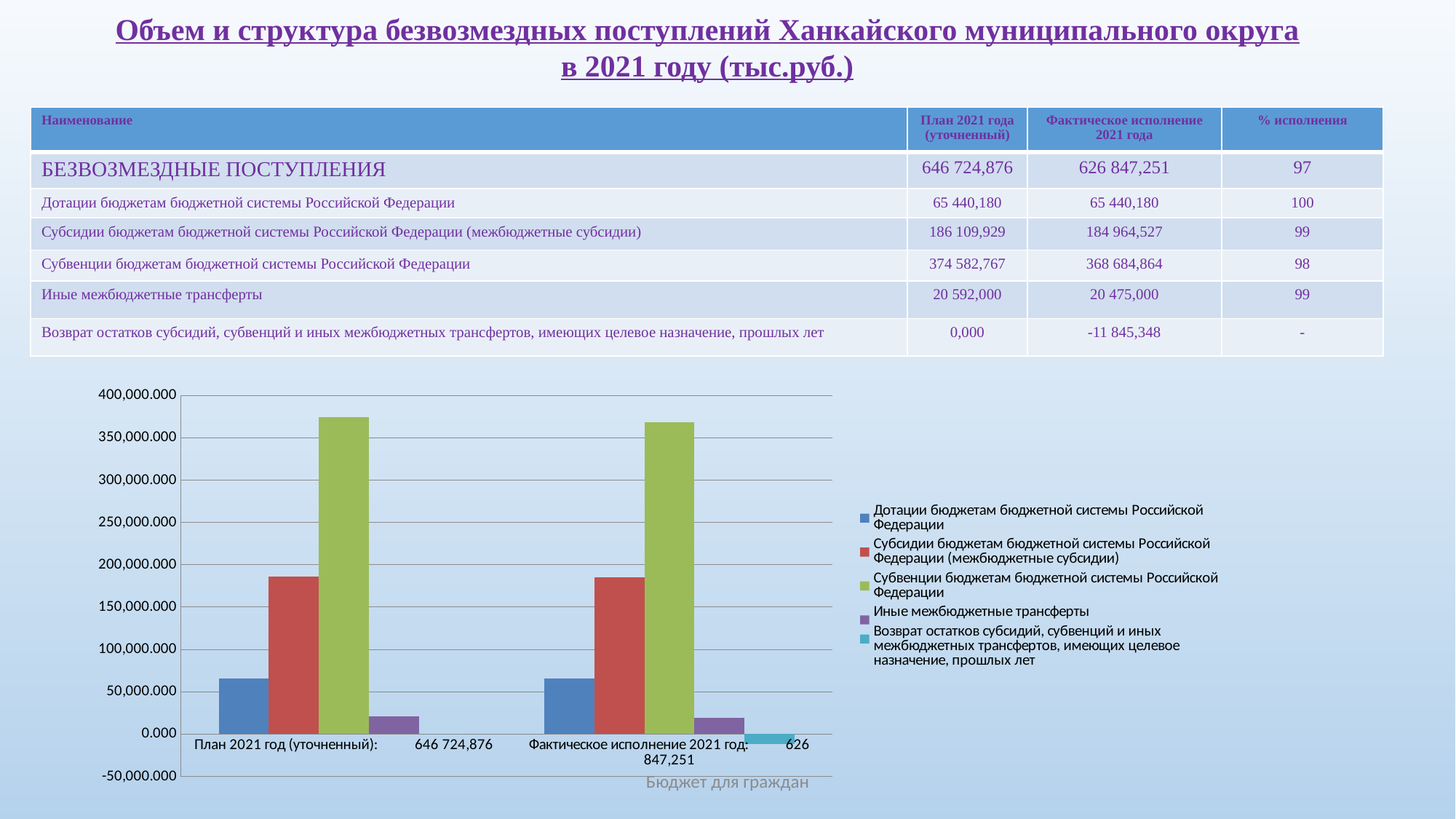
In the План 2021 год (уточненный) group, which series has the tallest bar? Субвенции бюджетам бюджетной системы Российской Федерации What total is printed in the x-axis label for the Фактическое исполнение 2021 год group? 626 847,251 Is the value for Дотации бюджетам бюджетной системы Российской Федерации in the План 2021 год (уточненный) group greater or less than 50,000.000? greater How many category groups are shown along the x axis of the chart? 2 What colour are the bars for Субвенции бюджетам бюджетной системы Российской Федерации in the chart? green In the Фактическое исполнение 2021 год group, which series has the lowest bar? Возврат остатков субсидий, субвенций и иных межбюджетных трансфертов, имеющих целевое назначение, прошлых лет What kind of chart is shown on the slide? bar chart In the План 2021 год (уточненный) group, which is larger: the bar for Субсидии бюджетам бюджетной системы Российской Федерации (межбюджетные субсидии) or the bar for Дотации бюджетам бюджетной системы Российской Федерации? Субсидии бюджетам бюджетной системы Российской Федерации (межбюджетные субсидии) Is the value for Возврат остатков субсидий, субвенций и иных межбюджетных трансфертов in the Фактическое исполнение 2021 год group greater or less than 0.000? less Is the value for Субвенции бюджетам бюджетной системы Российской Федерации in the План 2021 год (уточненный) group greater or less than 350,000.000? greater How many series does the chart legend list? 5